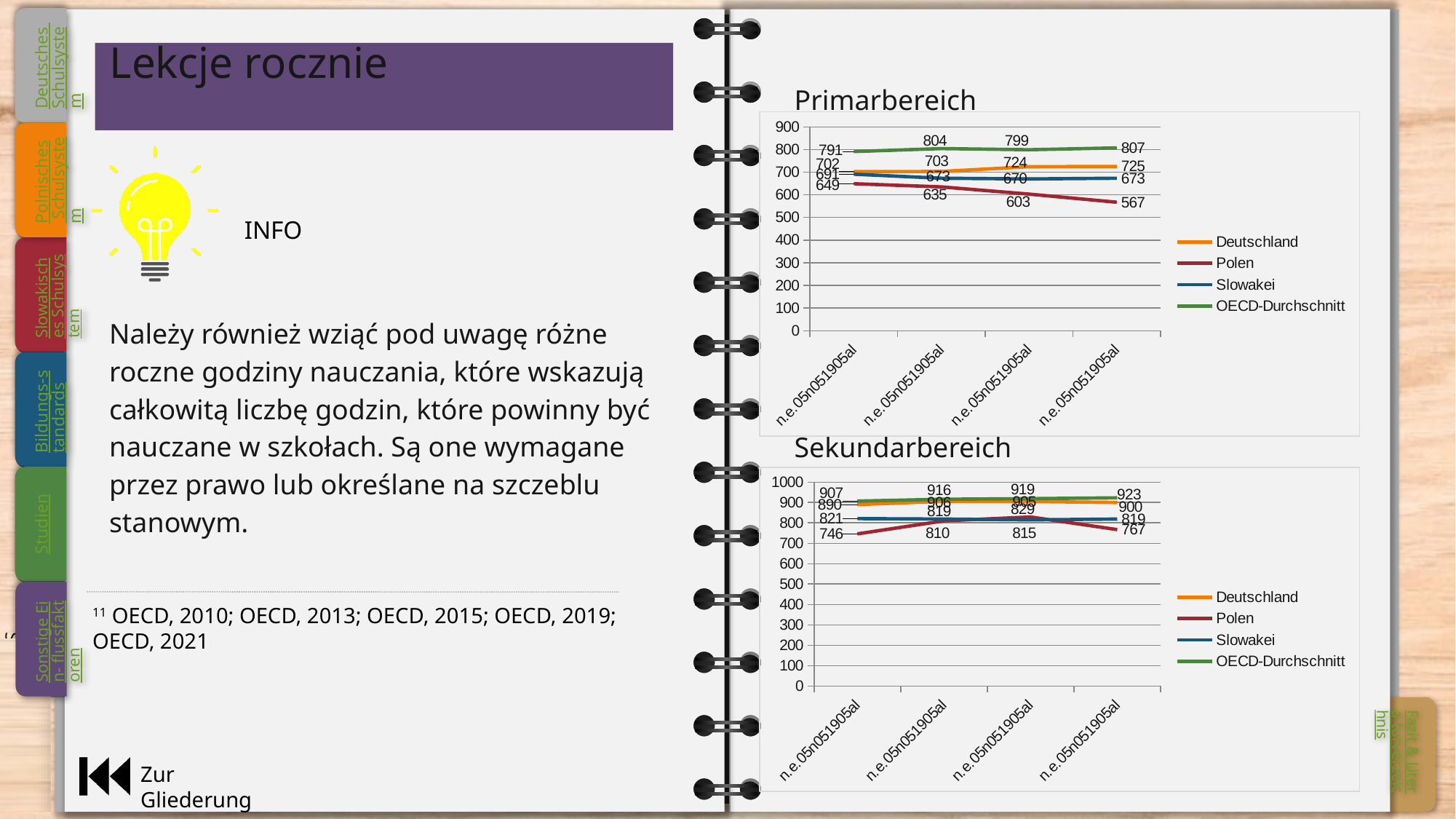
How many data points does each series have in the Primarbereich chart? 4 How many series does the legend of the Sekundarbereich chart list? 4 In the Primarbereich chart, what is the difference between OECD-Durchschnitt and Polen at the last point? 240 In the Sekundarbereich chart, by how much does the OECD-Durchschnitt value at the last point exceed its value at the first point? 16 In the Primarbereich chart, do the values for Polen rise or fall from left to right? fall In the Primarbereich chart, which series has the highest value at the last point? OECD-Durchschnitt In the Sekundarbereich chart, which series has the lowest value at the first point? Polen In the Sekundarbereich chart, do the values for OECD-Durchschnitt rise or fall from left to right? rise In the Sekundarbereich chart, what is the first (leftmost) value for Deutschland? 890 In the Primarbereich chart, what is the last (rightmost) value for Polen? 567 In the Sekundarbereich chart, is the value for Polen larger at the first point or at the last point? last point What kind of chart is the Primarbereich chart? line chart